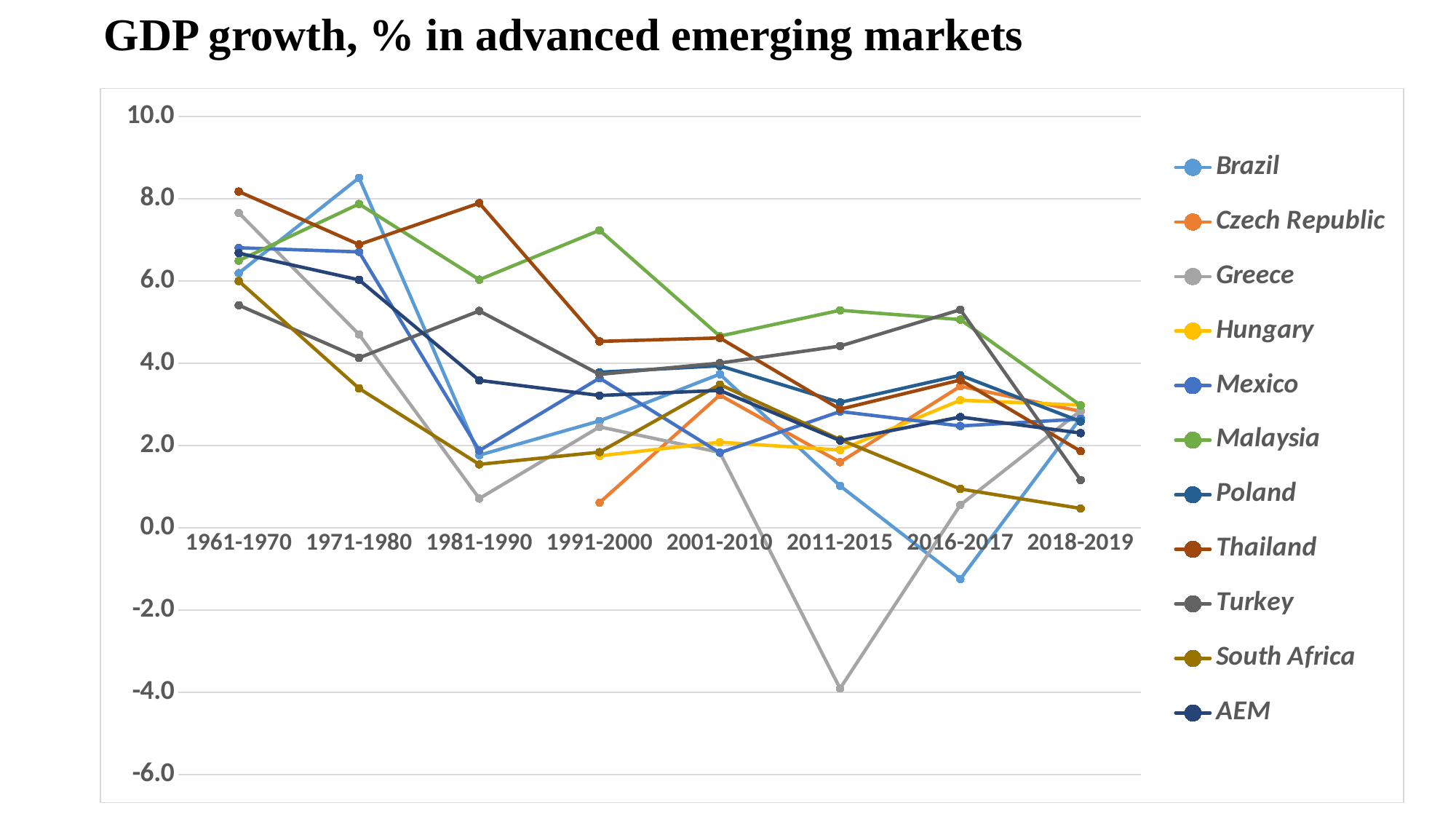
Which series has the highest value in 1991-2000? Malaysia Which series has the lowest value in 2011-2015? Greece How many series does the legend list? 11 What kind of chart is shown on the slide? line chart Which series has the lowest value in 2016-2017? Brazil Is the value for Greece in 2011-2015 greater or less than -2.0? less How many time periods are shown on the x axis? 8 Is the value for Thailand in 1961-1970 greater or less than 8.0? greater Which series has the highest value in 1971-1980? Brazil What is the title of the chart? GDP growth, % in advanced emerging markets Does the value for Thailand rise or fall overall from 1961-1970 to 2018-2019? fall In 2011-2015, which is larger: the value for Malaysia or the value for Greece? Malaysia